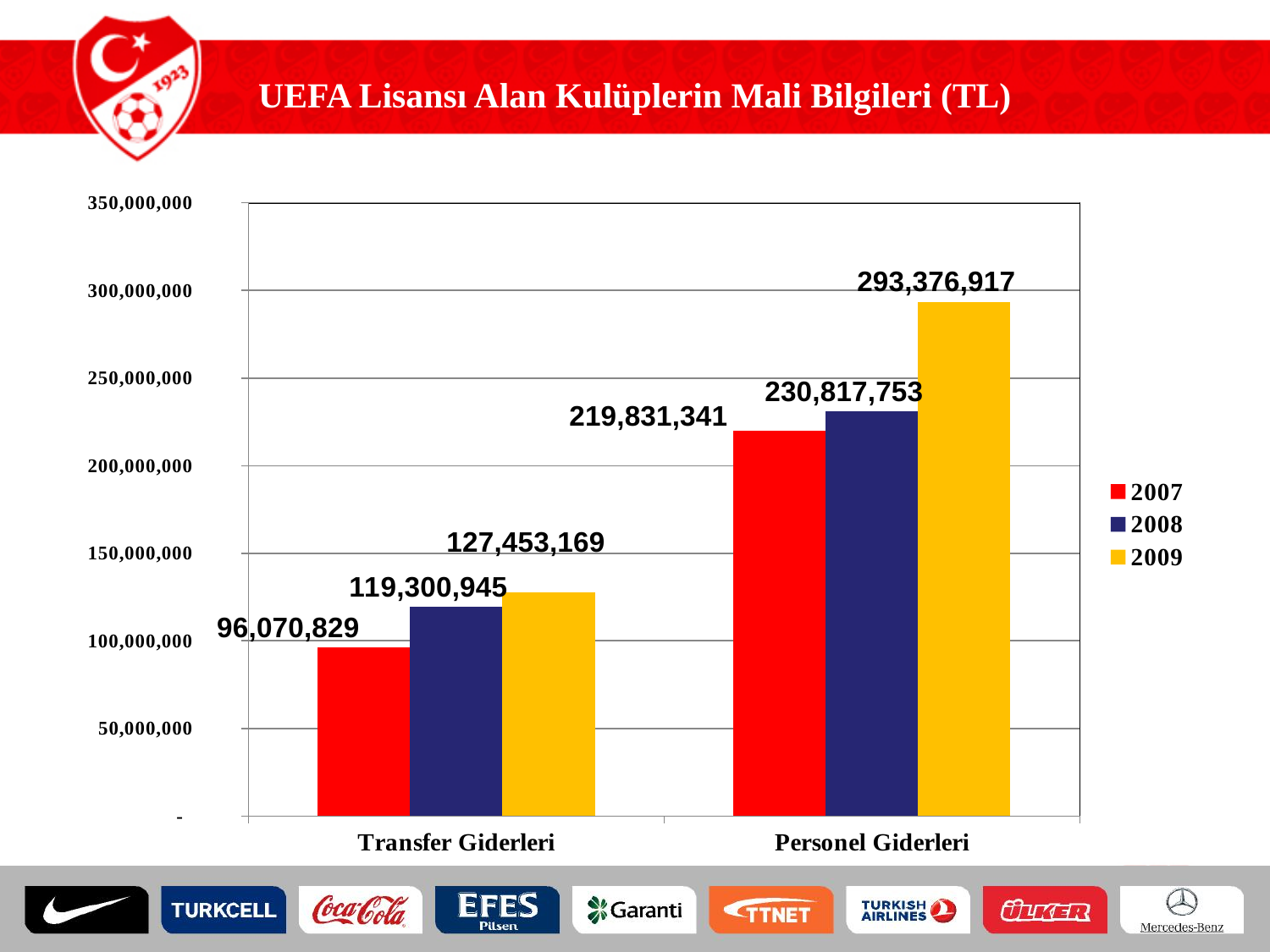
Which is larger: the 2009 value for Transfer Giderleri or the 2007 value for Personel Giderleri? 2007 value for Personel Giderleri What kind of chart is shown on the slide? Bar chart Which year has the highest value in the Personel Giderleri category? 2009 How many series does the legend list? 3 What is the difference between the 2009 and 2007 values for Transfer Giderleri? 31,382,340 What is the value for 2007 in the Personel Giderleri category? 219,831,341 What is the value for 2007 in the Transfer Giderleri category? 96,070,829 What is the difference between the 2009 and 2007 values for Personel Giderleri? 73,545,576 What is the value for 2009 in the Personel Giderleri category? 293,376,917 Do the values for Personel Giderleri rise or fall from 2007 to 2009? Rise Which year has the lowest value in the Transfer Giderleri category? 2007 What is the value for 2008 in the Transfer Giderleri category? 119,300,945